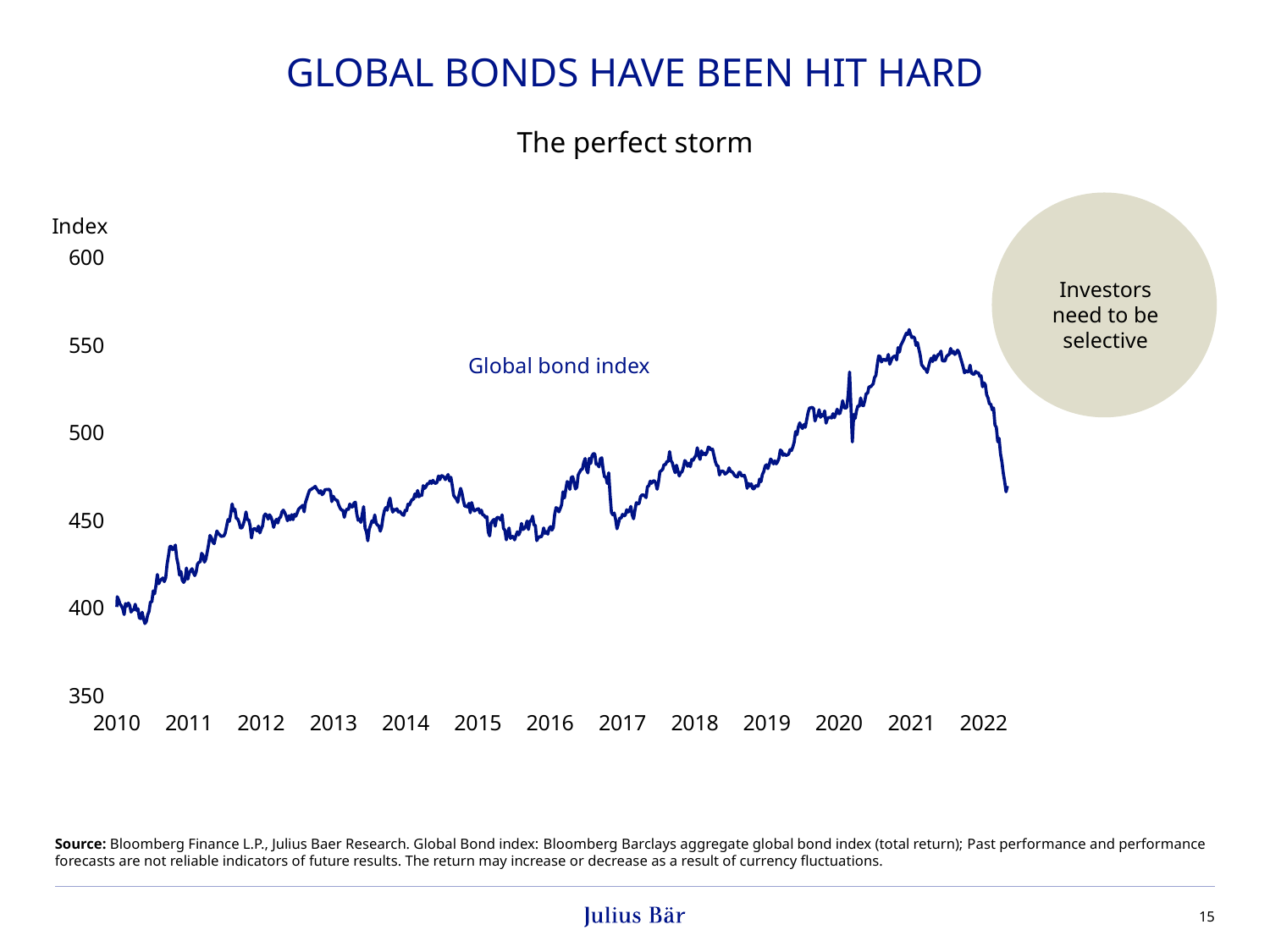
In which year does the Global bond index reach its lowest point? 2010 What is the label on the vertical axis of the chart? Index Is the peak value of the Global bond index in 2021 greater or less than 550? greater In which year does the Global bond index reach its highest point? 2021 How many year labels are shown on the x axis? 13 Is the value of the Global bond index at the start of 2010 greater or less than 450? less Does the Global bond index rise or fall from its 2021 peak to the end of the line in 2022? fall Is the value of the Global bond index at the start of 2019 greater or less than 450? greater What is the name of the series plotted on the chart? Global bond index How many series are plotted on the chart? 1 What kind of chart is shown on the slide? line chart